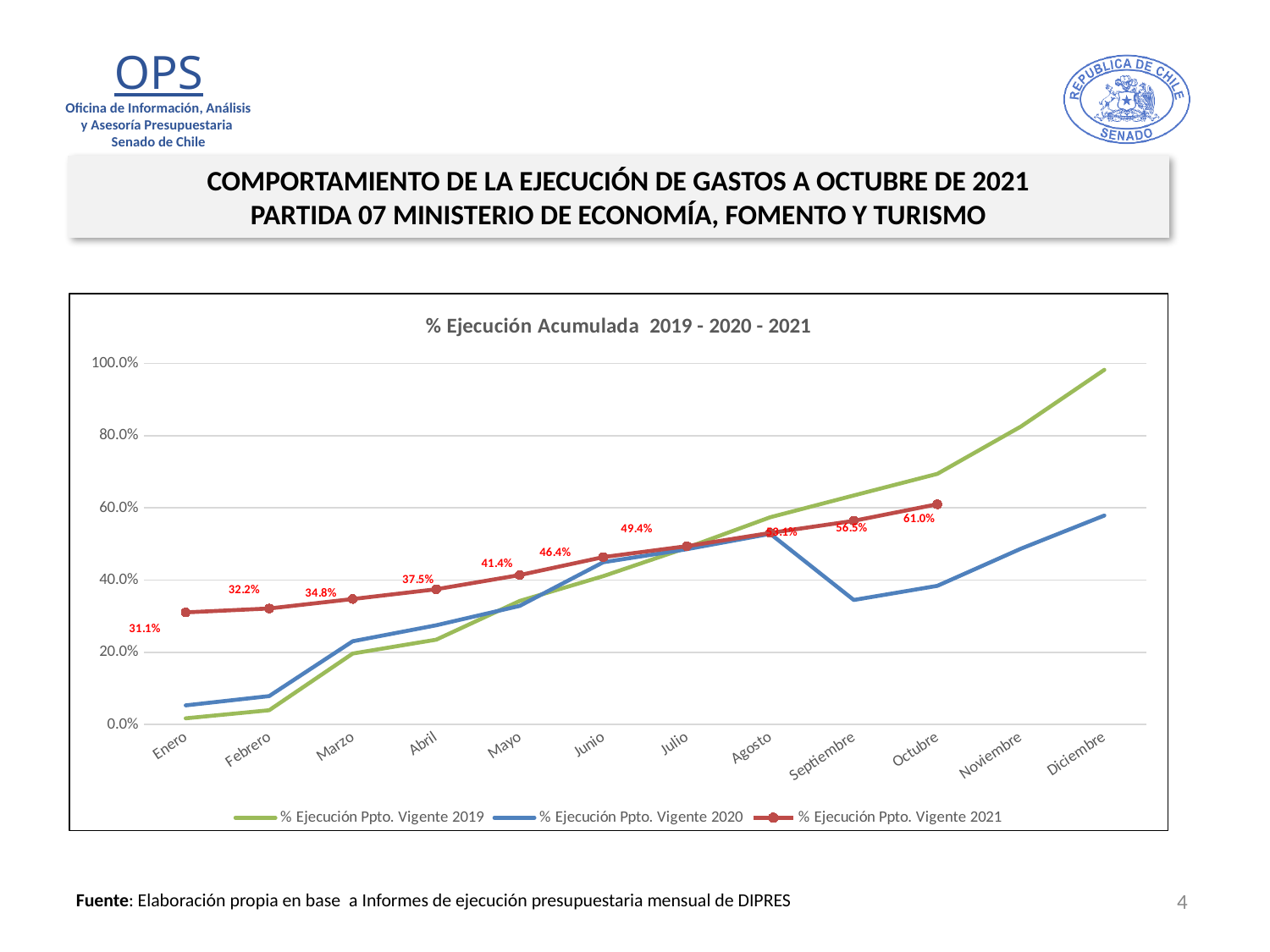
What type of chart is shown on the slide? line chart How many series does the legend list? 3 What is the value of % Ejecución Ppto. Vigente 2021 for Enero? 31.1% Which month has the highest value for % Ejecución Ppto. Vigente 2021? Octubre What is the value of % Ejecución Ppto. Vigente 2021 for Mayo? 41.4% What is the value of % Ejecución Ppto. Vigente 2021 for Octubre? 61.0% Which is larger in Septiembre: % Ejecución Ppto. Vigente 2020 or % Ejecución Ppto. Vigente 2021? % Ejecución Ppto. Vigente 2021 What is the title of the chart? % Ejecución Acumulada 2019 - 2020 - 2021 What is the difference between the % Ejecución Ppto. Vigente 2021 values for Octubre and Enero? 29.9% Is the value of % Ejecución Ppto. Vigente 2019 for Diciembre greater or less than 80.0%? greater Does the % Ejecución Ppto. Vigente 2021 series rise or fall from Enero to Octubre? rise How many months are shown on the x axis? 12